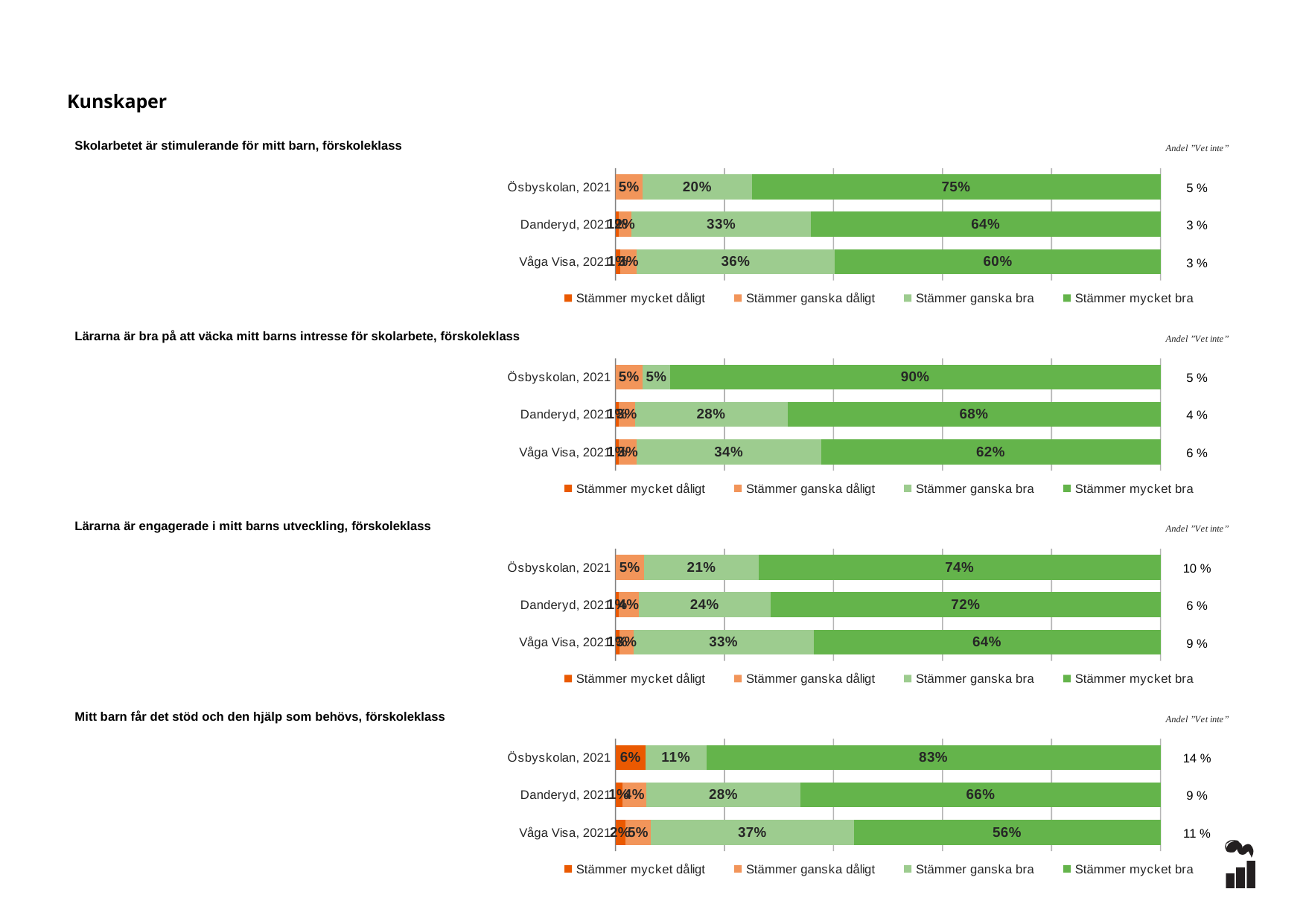
How many rows (categories) does the chart 'Skolarbetet är stimulerande för mitt barn, förskoleklass' show? 3 How many series does the legend of the chart 'Lärarna är engagerade i mitt barns utveckling, förskoleklass' list? 4 In the chart 'Mitt barn får det stöd och den hjälp som behövs, förskoleklass', is the 'Stämmer ganska bra' value larger for Danderyd, 2021 or Våga Visa, 2021? Våga Visa, 2021 In the chart 'Mitt barn får det stöd och den hjälp som behövs, förskoleklass', what is the 'Stämmer mycket dåligt' value for Ösbyskolan, 2021? 6% What kind of chart is used for 'Mitt barn får det stöd och den hjälp som behövs, förskoleklass'? Stacked bar chart In the chart 'Skolarbetet är stimulerande för mitt barn, förskoleklass', what is the 'Stämmer mycket bra' value for Ösbyskolan, 2021? 75% In the chart 'Lärarna är engagerade i mitt barns utveckling, förskoleklass', what is the difference between the 'Stämmer mycket bra' values for Ösbyskolan, 2021 and Våga Visa, 2021? 10% In the chart 'Lärarna är bra på att väcka mitt barns intresse för skolarbete, förskoleklass', which row has the highest 'Stämmer mycket bra' value? Ösbyskolan, 2021 In the chart 'Lärarna är bra på att väcka mitt barns intresse för skolarbete, förskoleklass', what is the 'Stämmer mycket bra' value for Ösbyskolan, 2021? 90% In the chart 'Skolarbetet är stimulerande för mitt barn, förskoleklass', what is the 'Stämmer ganska bra' value for Våga Visa, 2021? 36% In the chart 'Mitt barn får det stöd och den hjälp som behövs, förskoleklass', which row has the lowest 'Stämmer mycket bra' value? Våga Visa, 2021 In the chart 'Lärarna är engagerade i mitt barns utveckling, förskoleklass', what is the 'Andel Vet inte' value for Ösbyskolan, 2021? 10 %